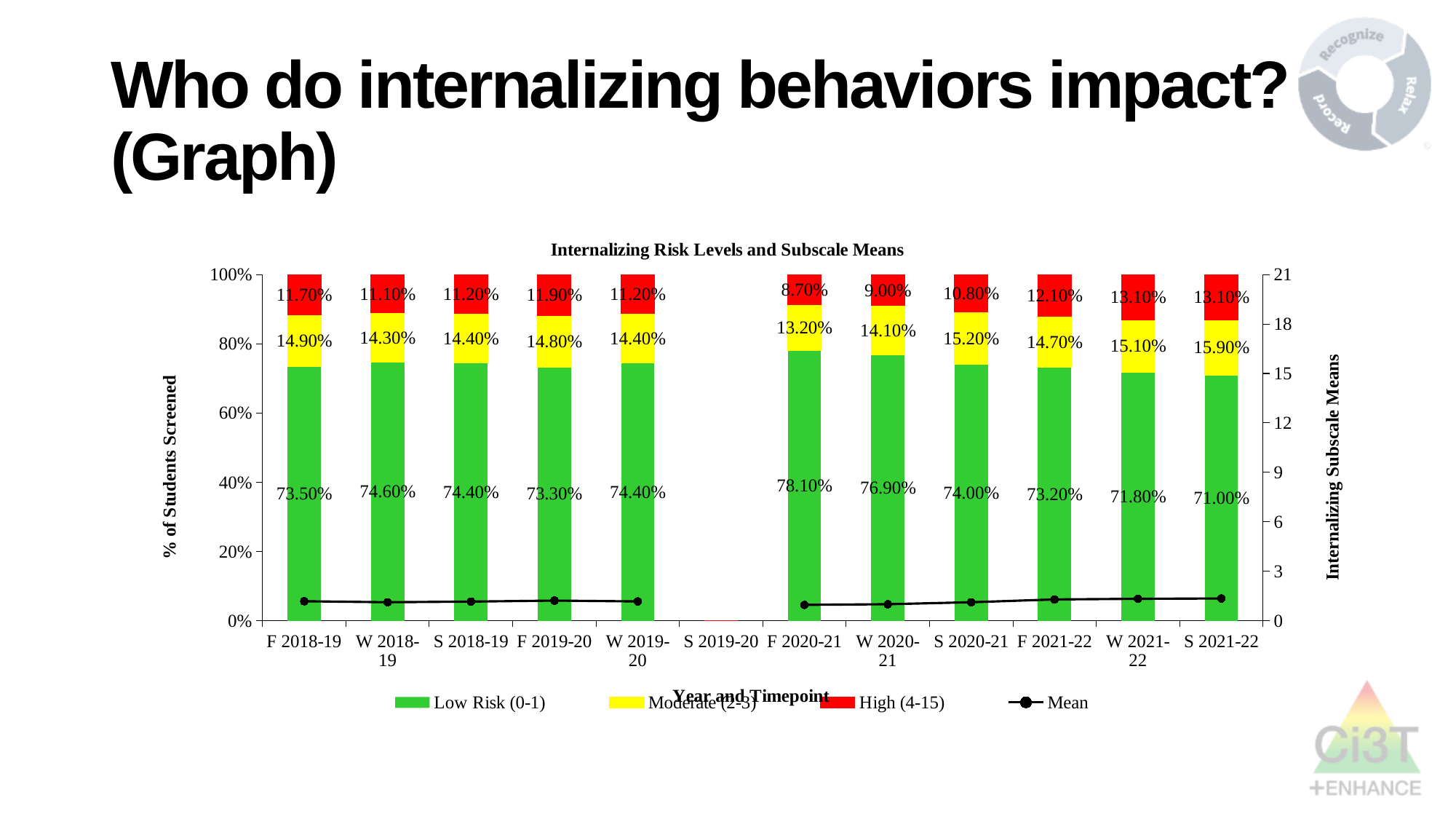
What is the High (4-15) percentage for W 2021-22? 13.10% What is the Low Risk (0-1) percentage for F 2020-21? 78.10% Which is larger, the Low Risk (0-1) percentage for W 2018-19 or for S 2021-22? W 2018-19 Which timepoint has the lowest High (4-15) percentage? F 2020-21 Which timepoint has the highest Low Risk (0-1) percentage? F 2020-21 How many series does the legend list? 4 What is the Moderate (2-3) percentage for F 2019-20? 14.80% Is the Mean value for F 2020-21 greater or less than 3 on the right axis? less How many timepoints are shown on the x axis? 12 What is the difference in the High (4-15) percentage between F 2021-22 and F 2020-21? 3.40% Does the Low Risk (0-1) percentage rise or fall from F 2020-21 to S 2021-22? fall Which timepoint has the highest Moderate (2-3) percentage? S 2021-22